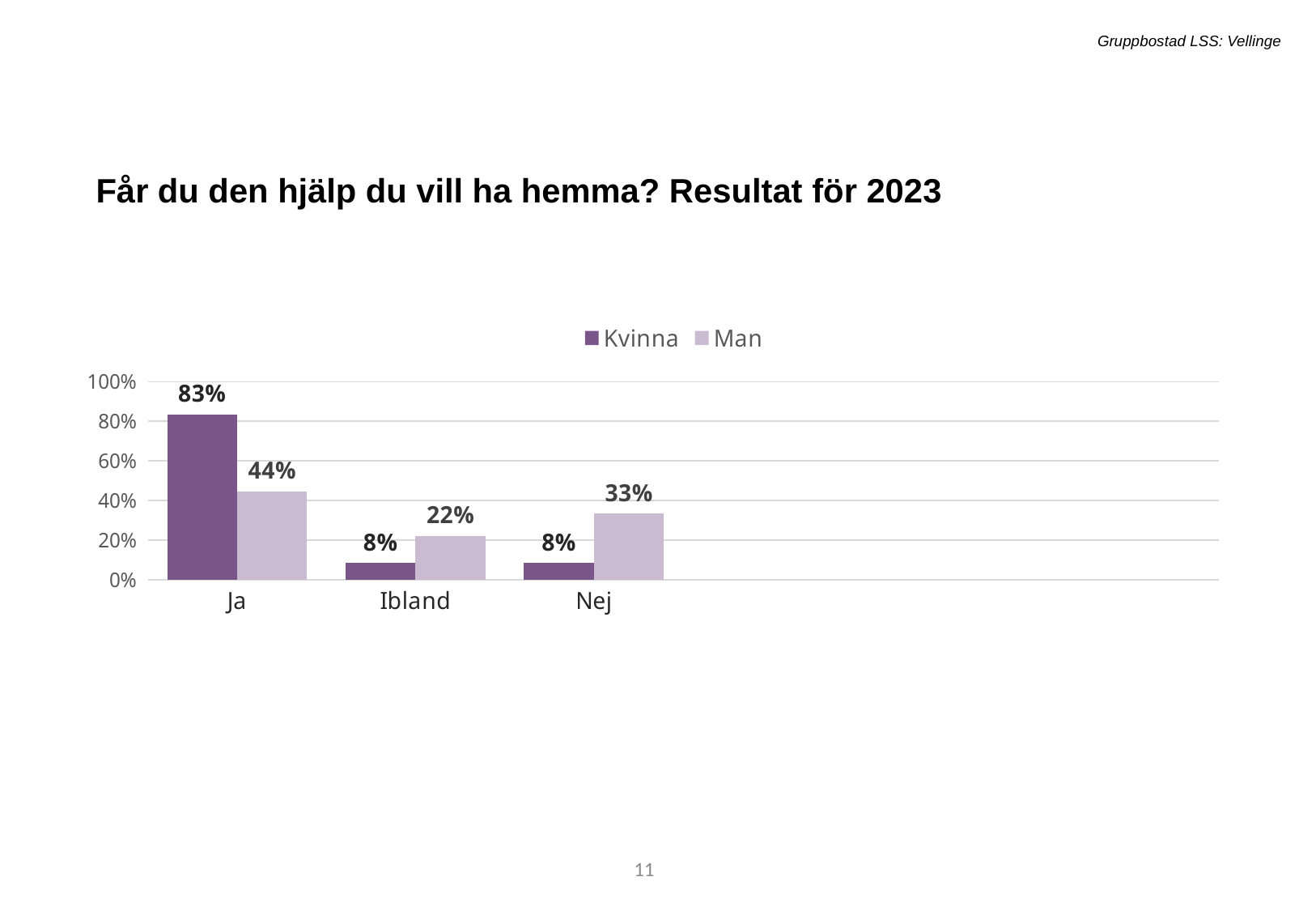
What kind of chart is shown on the slide? Bar chart What is the difference between the Kvinna and Man values in the Ja category? 39% How many categories are shown on the x axis? 3 What is the value for Kvinna in the Ja category? 83% What is the value for Man in the Ibland category? 22% Is the value for Man in the Ja category greater or less than 40%? greater Which category has the highest value for the Kvinna series? Ja In the Nej category, which series has the larger value, Kvinna or Man? Man What is the value for Man in the Nej category? 33% Which category has the lowest value for the Man series? Ibland What are the two series named in the legend? Kvinna and Man How many series does the legend list? 2